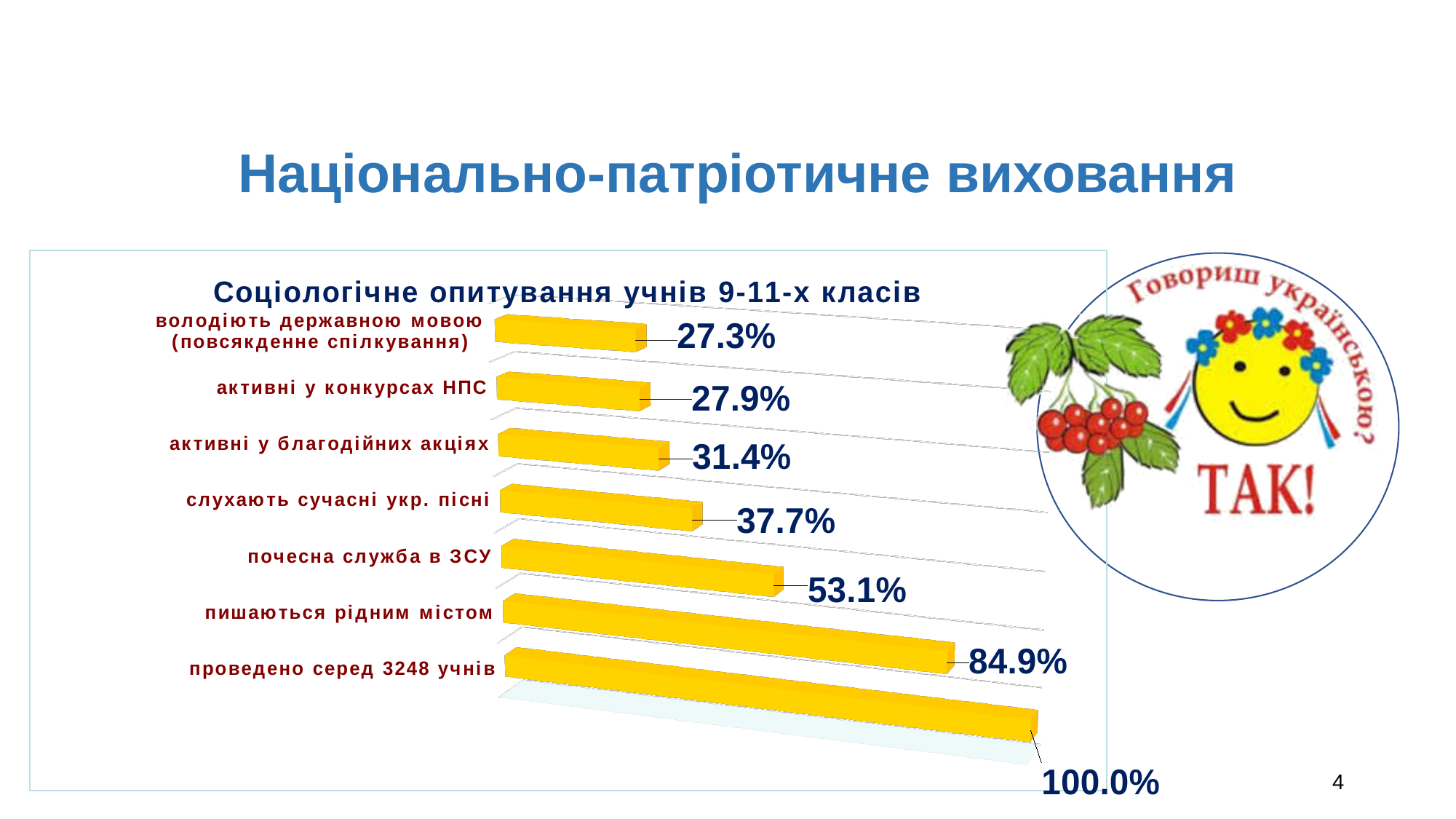
What is the value for "почесна служба в ЗСУ"? 53.1% Which category has the lowest value? володіють державною мовою (повсякденне спілкування) What is the title of the chart? Соціологічне опитування учнів 9-11-х класів What is the value for "слухають сучасні укр. пісні"? 37.7% What is the difference between the values for "пишаються рідним містом" and "почесна служба в ЗСУ"? 31.8% What is the value for "володіють державною мовою (повсякденне спілкування)"? 27.3% How many categories are shown in the chart? 7 Which is larger, the value for "слухають сучасні укр. пісні" or for "активні у благодійних акціях"? слухають сучасні укр. пісні What is the value for "пишаються рідним містом"? 84.9% Which category has the highest value? проведено серед 3248 учнів What is the value for "активні у благодійних акціях"? 31.4% What is the value for "активні у конкурсах НПС"? 27.9%